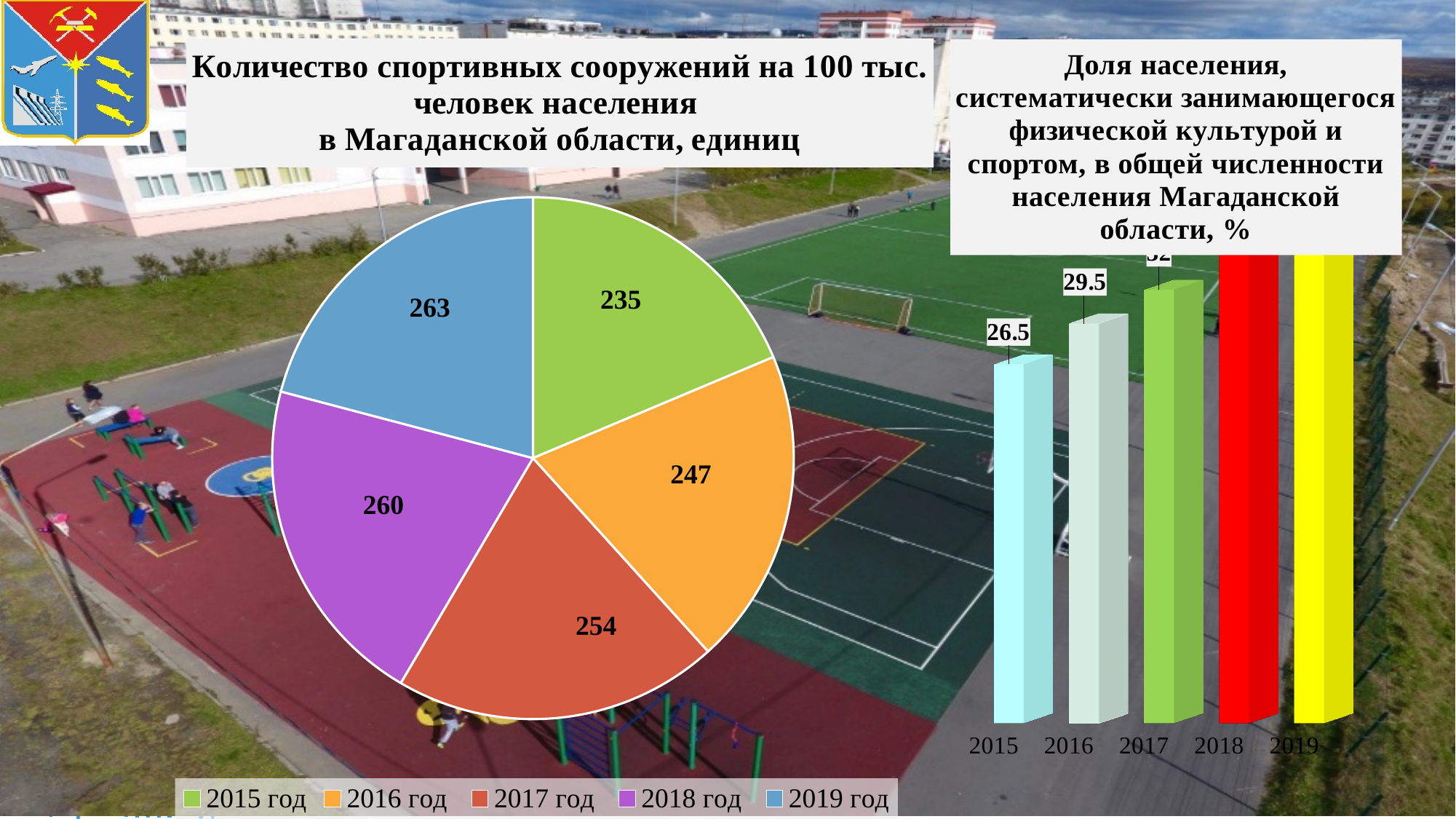
How many slices does the pie chart on the left have? 5 What kind of chart is the chart on the left of the slide? pie chart In the bar chart on the right, what is the value for 2016? 29.5 In the pie chart on the left, what is the value for 2016 год? 247 In the pie chart on the left, which year has the lowest value? 2015 год In the pie chart on the left, what colour is the slice for 2018 год? purple In the bar chart on the right, what is the difference between the values for 2016 and 2015? 3 In the pie chart on the left, what is the difference between the values for 2019 год and 2015 год? 28 In the bar chart on the right, do the values rise or fall from 2015 to 2019? rise In the pie chart on the left, which year has the highest value? 2019 год In the pie chart on the left, what is the value for 2019 год? 263 In the bar chart on the right, what is the value for 2015? 26.5